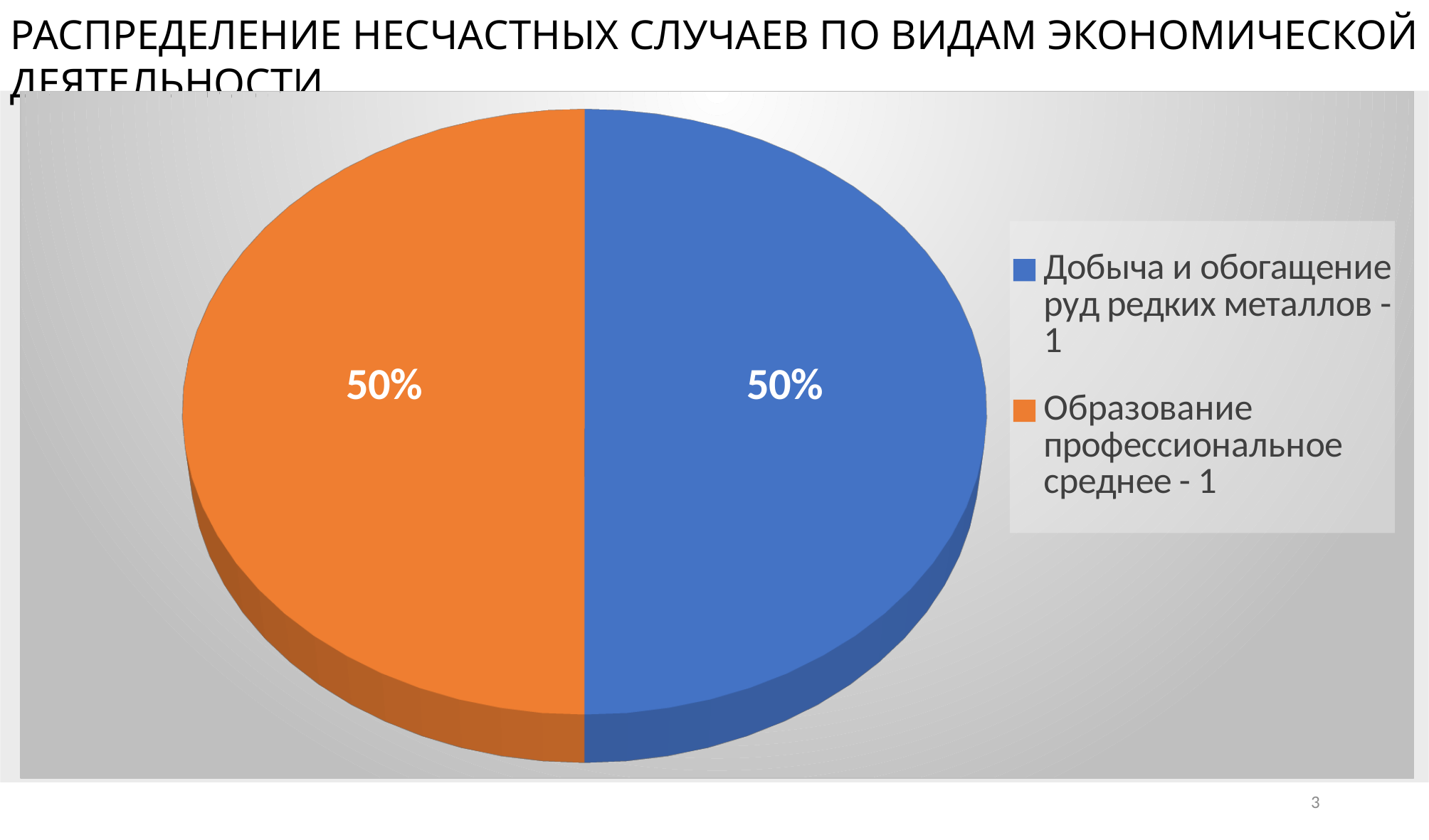
Is the share for "Образование профессиональное среднее - 1" greater or less than 25%? greater What is the difference between the shares of the two slices? 0% Which colour is used for the slice "Добыча и обогащение руд редких металлов - 1"? Blue What share of the pie does the slice for "Добыча и обогащение руд редких металлов - 1" represent? 50% Which colour is used for the slice "Образование профессиональное среднее - 1"? Orange How many entries does the legend list? 2 What kind of chart is shown on the slide? Pie chart What is the total of the two percentages shown on the pie chart? 100% Is the share for "Добыча и обогащение руд редких металлов - 1" greater or less than 75%? less How many slices does the pie chart have? 2 What share of the pie does the slice for "Образование профессиональное среднее - 1" represent? 50%